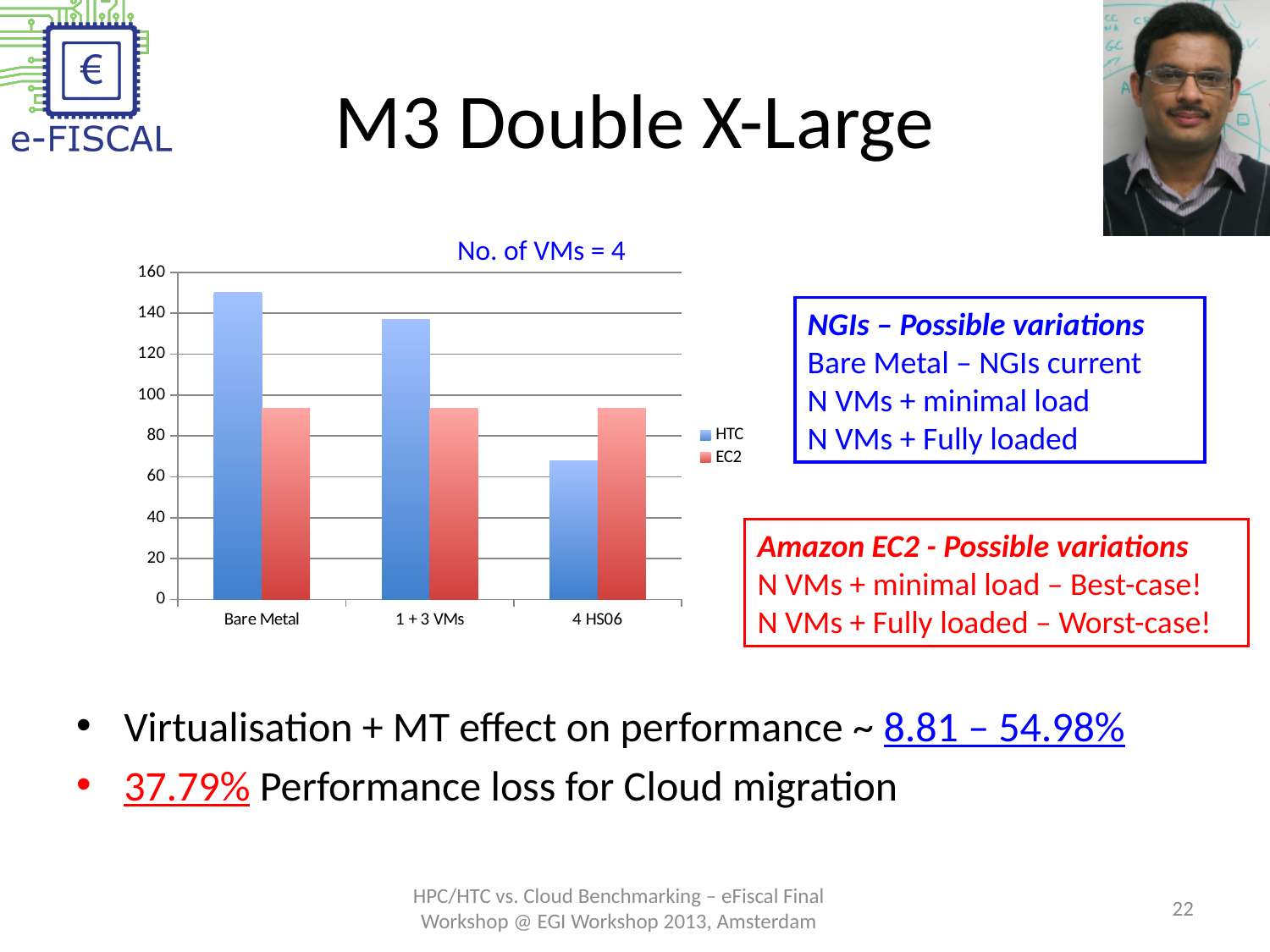
What is the title of the chart? No. of VMs = 4 Which category has the lowest HTC value? 4 HS06 For 4 HS06, which series has the larger value, HTC or EC2? EC2 Which category has the highest HTC value? Bare Metal How many categories are shown on the x axis of the chart? 3 For Bare Metal, which series has the larger value, HTC or EC2? HTC Is the EC2 value for Bare Metal greater or less than 100? less Is the HTC value for Bare Metal greater or less than 140? greater What kind of chart is shown on the slide? bar chart Do the HTC values rise or fall moving from Bare Metal to 4 HS06 along the x axis? fall Is the HTC value for 4 HS06 greater or less than 80? less How many series does the chart legend list? 2